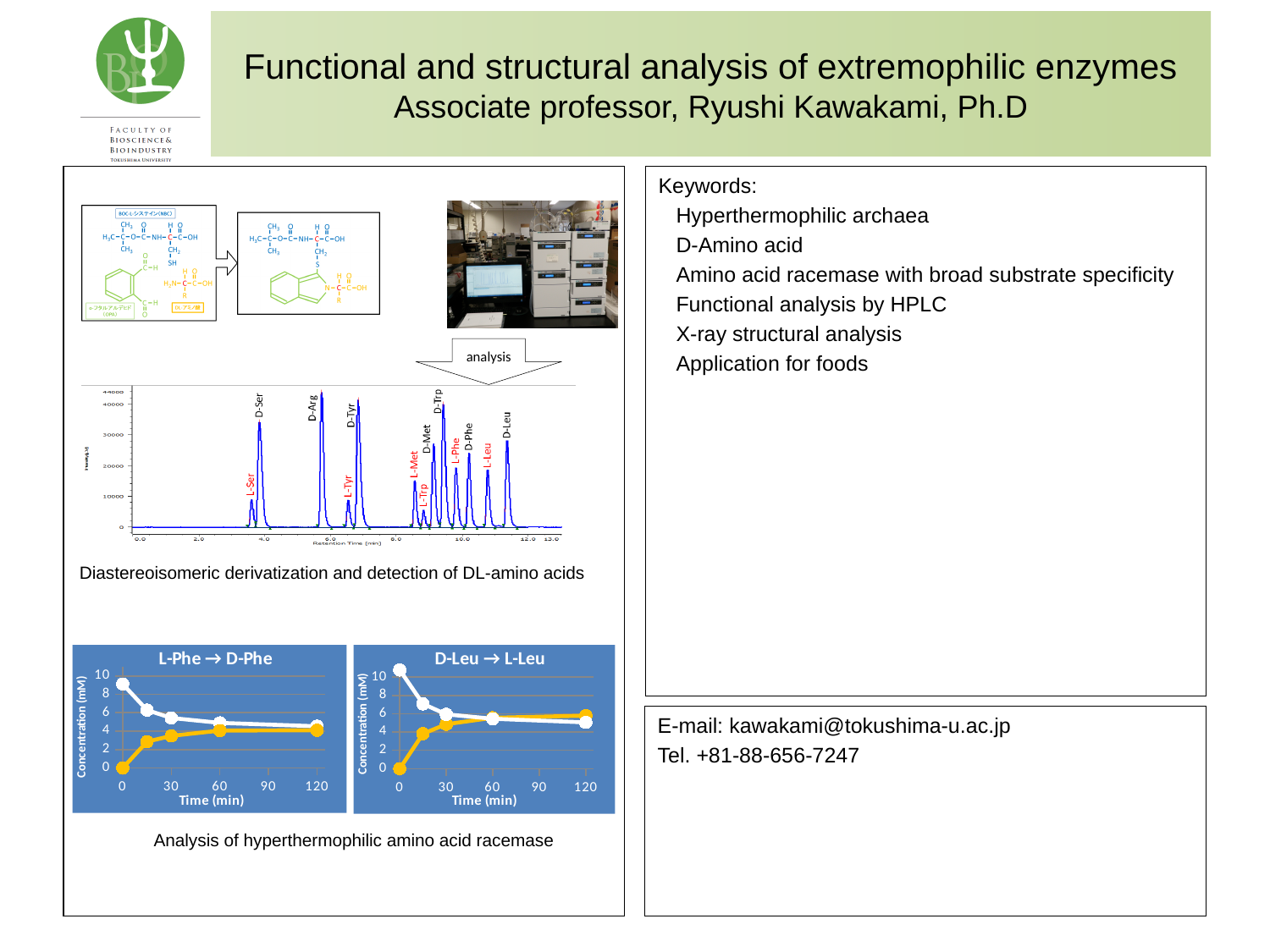
In the chart titled "L-Phe → D-Phe", does the white series rise or fall as time increases? fall In the chart titled "D-Leu → L-Leu", what is the label of the x axis? Time (min) In the chart titled "L-Phe → D-Phe", is the value of the orange series at time 0 greater or less than 2? less In the chart titled "D-Leu → L-Leu", how many data points does the white series have? 5 In the chart titled "L-Phe → D-Phe", what kind of chart is shown? line chart In the chromatogram chart above the caption "Diastereoisomeric derivatization and detection of DL-amino acids", is the L-Ser peak greater or less than 10000? less In the chart titled "L-Phe → D-Phe", does the orange series rise or fall as time increases? rise In the chromatogram chart above the caption "Diastereoisomeric derivatization and detection of DL-amino acids", is the D-Ser peak greater or less than 30000? greater In the chart titled "D-Leu → L-Leu", does the white series rise or fall as time increases? fall In the chart titled "L-Phe → D-Phe", what is the label of the y axis? Concentration (mM)